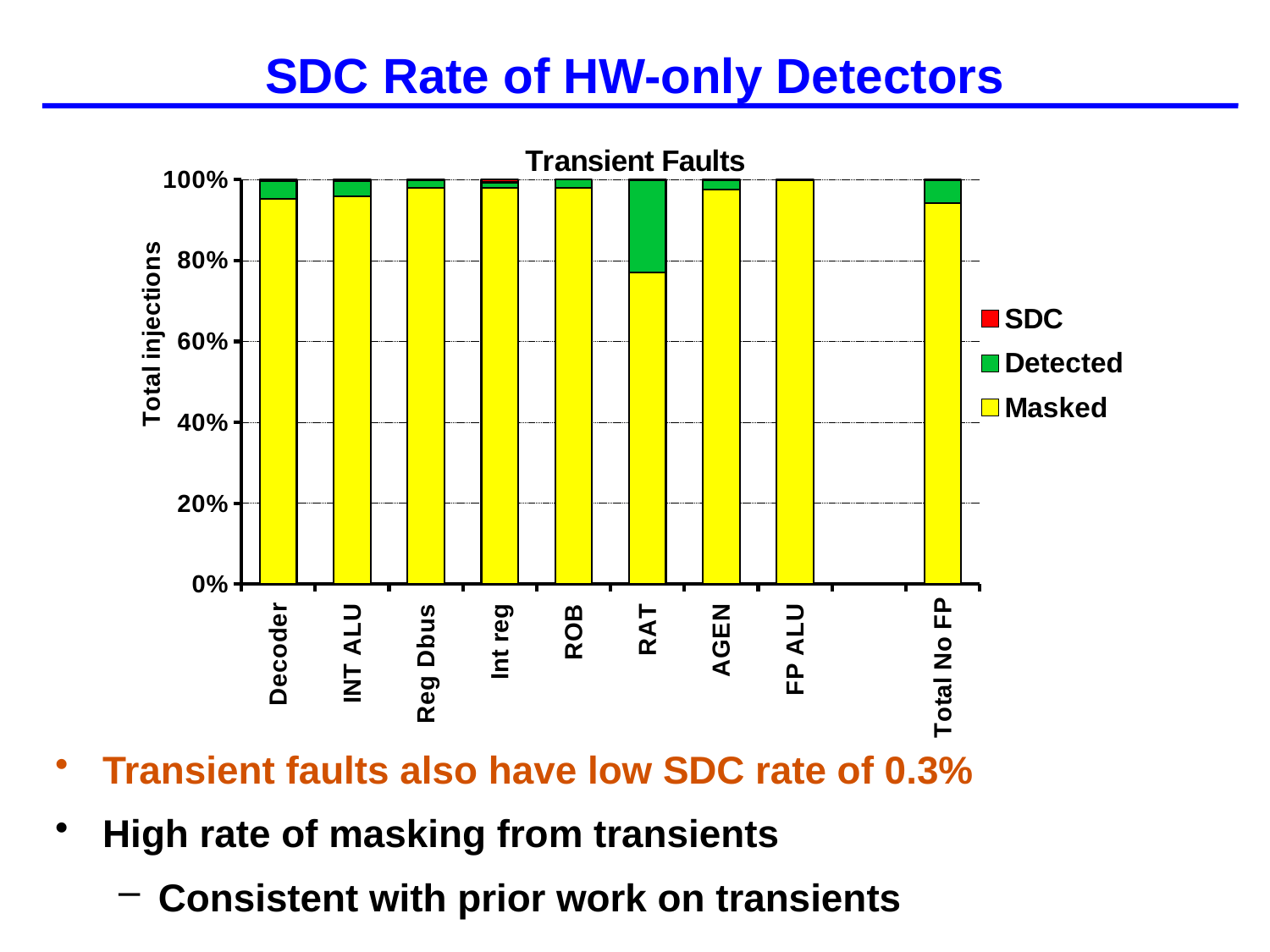
How many categories are shown along the x axis of the chart? 9 How many series does the chart's legend list? 3 What is the total height of the stacked bar for RAT? 100% Which has a larger Detected share, RAT or Decoder? RAT Which category has the largest Detected share? RAT Which colour represents the Masked series in the chart? yellow Is the Masked value for Decoder greater or less than 80%? greater What is the title of the chart? Transient Faults Is the Detected value for RAT greater or less than 20%? greater Is the Masked value for RAT greater or less than 80%? less Which category has the smallest Masked share? RAT What kind of chart is shown on the slide? stacked bar chart